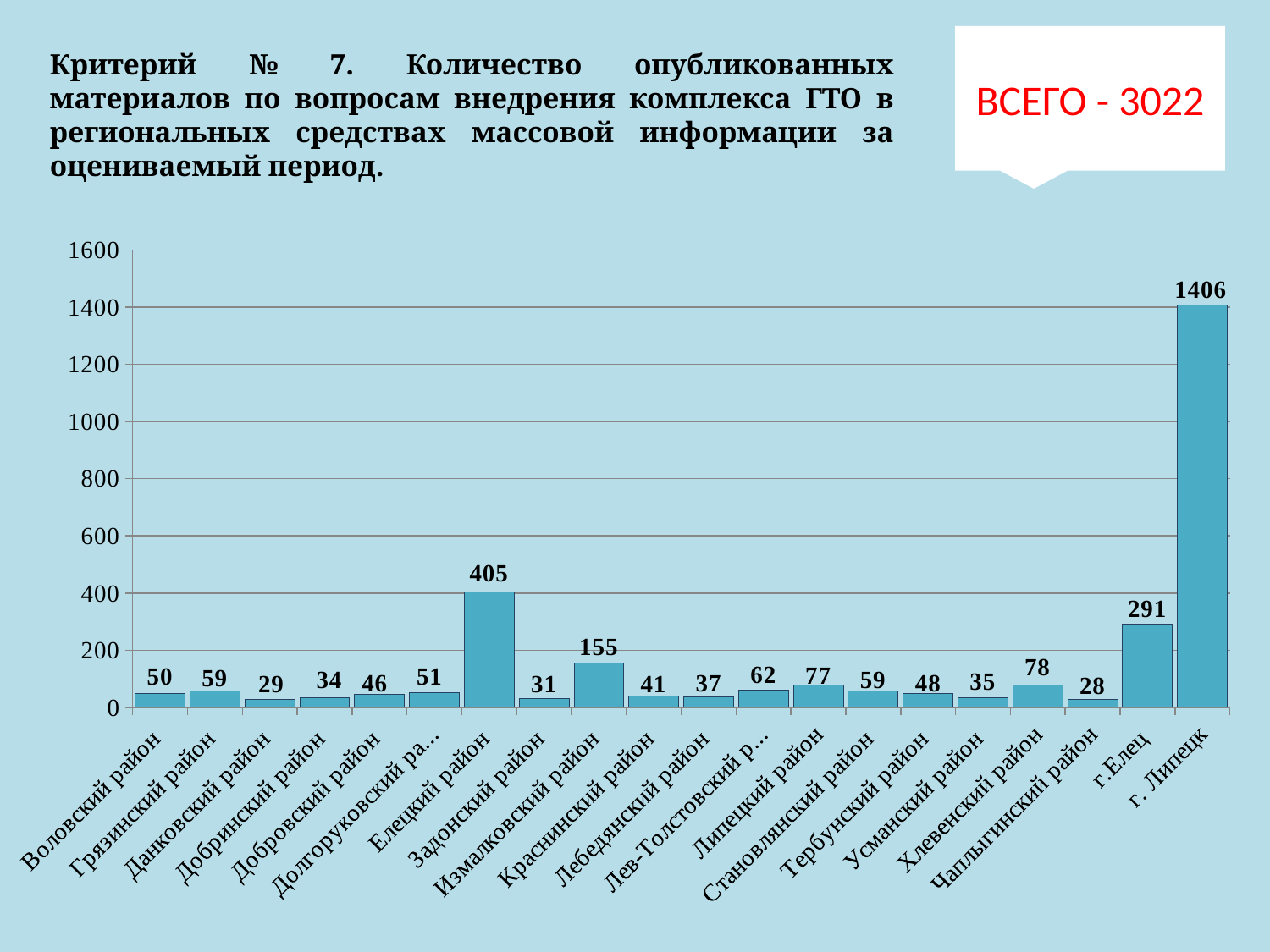
What is the value for г.Елец? 291 What is the value for Хлевенский район? 78 What is the difference between the values for г. Липецк and Елецкий район? 1001 Which category has the lowest value? Чаплыгинский район How many categories are shown on the x axis? 20 Is the value for г. Липецк greater or less than 1200? greater What is the value for Елецкий район? 405 Which is larger, the value for Задонский район or the value for Краснинский район? Краснинский район What is the difference between the values for Липецкий район and Лебедянский район? 40 What kind of chart is shown on the slide? bar chart What is the value for Измалковский район? 155 Which category has the highest value? г. Липецк